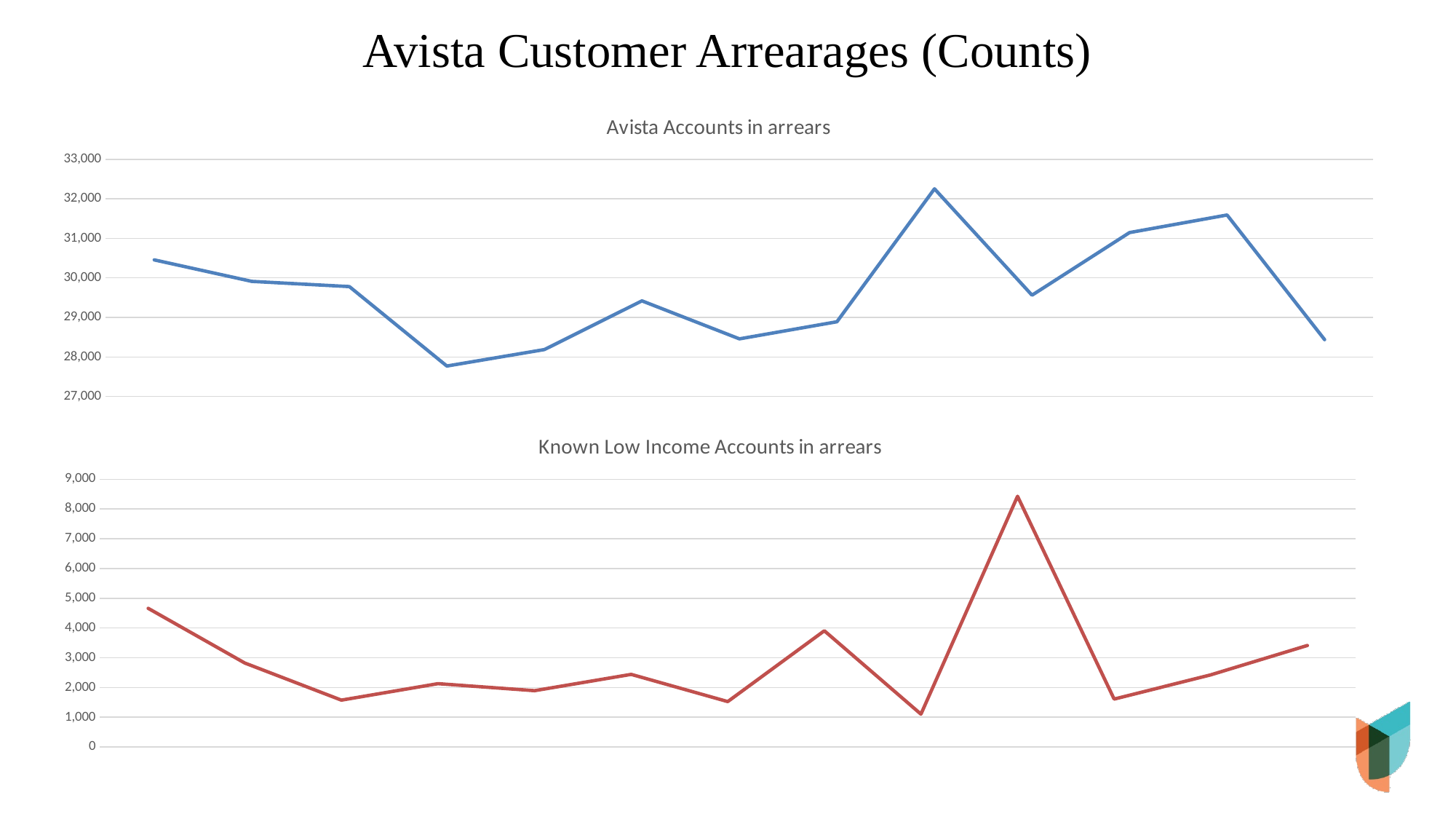
In the 'Avista Accounts in arrears' chart, is the highest point on the line greater or less than 32,000? greater In the 'Known Low Income Accounts in arrears' chart, is the highest point on the line greater or less than 8,000? greater In the 'Avista Accounts in arrears' chart, is the first point on the line greater or less than 30,000? greater How many data points are plotted on the 'Avista Accounts in arrears' line? 13 How many data points are plotted on the 'Known Low Income Accounts in arrears' line? 13 What kind of chart is the 'Known Low Income Accounts in arrears' chart? line chart What kind of chart is the 'Avista Accounts in arrears' chart? line chart In the 'Known Low Income Accounts in arrears' chart, which is higher, the first point or the last point on the line? the first point What colour is the line in the 'Known Low Income Accounts in arrears' chart? red In the 'Avista Accounts in arrears' chart, does the line rise or fall between the first point and the fourth point? fall